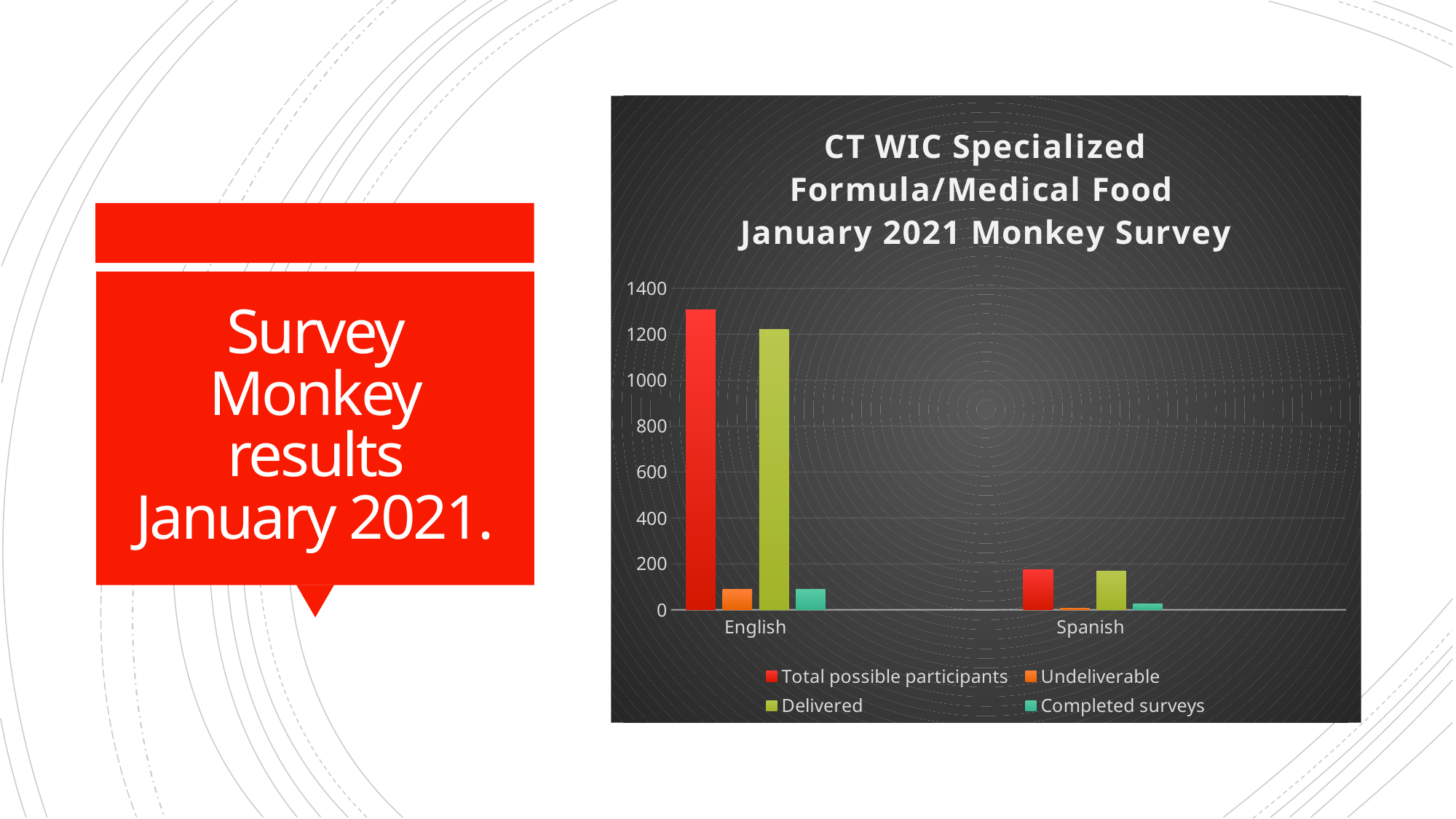
How many series does the chart's legend list? 4 Which is larger: Total possible participants for English or Total possible participants for Spanish? English Is the value for Delivered for English greater or less than 1400? less Which series has the lowest value for Spanish? Undeliverable Which is larger: Delivered for Spanish or Completed surveys for Spanish? Delivered How many categories are shown on the x axis of the chart? 2 Which series has the highest value for English? Total possible participants What is the title of the chart? CT WIC Specialized Formula/Medical Food January 2021 Monkey Survey Is the value for Total possible participants for English greater or less than 1200? greater What kind of chart is shown on the slide? bar chart Is the value for Total possible participants for Spanish greater or less than 200? less